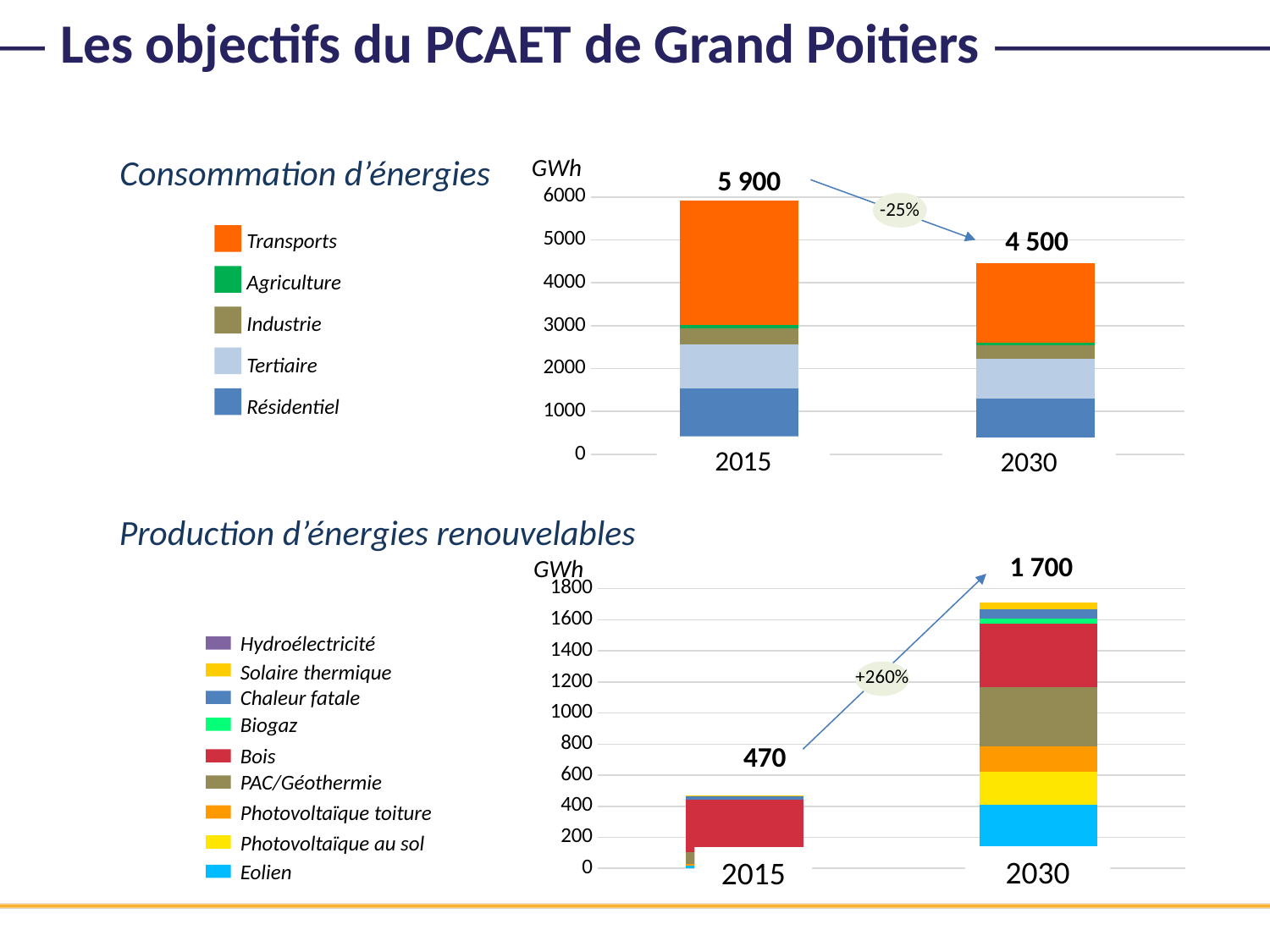
In the 'Production d'énergies renouvelables' chart, what is the total production shown for 2015? 470 In the 'Production d'énergies renouvelables' chart, how many series does the legend list? 9 In the 'Consommation d'énergies' chart, how many series does the legend list? 5 In the 'Consommation d'énergies' chart, what is the total energy consumption shown for 2015? 5 900 In the 'Production d'énergies renouvelables' chart, what is the total production shown for 2030? 1 700 In the 'Production d'énergies renouvelables' chart, what percentage change is annotated between 2015 and 2030? +260% In the 'Consommation d'énergies' chart, what percentage change is annotated between 2015 and 2030? -25% What kind of chart is the 'Consommation d'énergies' chart? stacked bar chart In the 'Consommation d'énergies' chart, which year has the higher total consumption, 2015 or 2030? 2015 In the 'Production d'énergies renouvelables' chart, do the totals rise or fall from 2015 to 2030? rise In the 'Consommation d'énergies' chart, what is the total energy consumption shown for 2030? 4 500 In the 'Consommation d'énergies' chart, what is the difference between the 2015 total and the 2030 total? 1 400